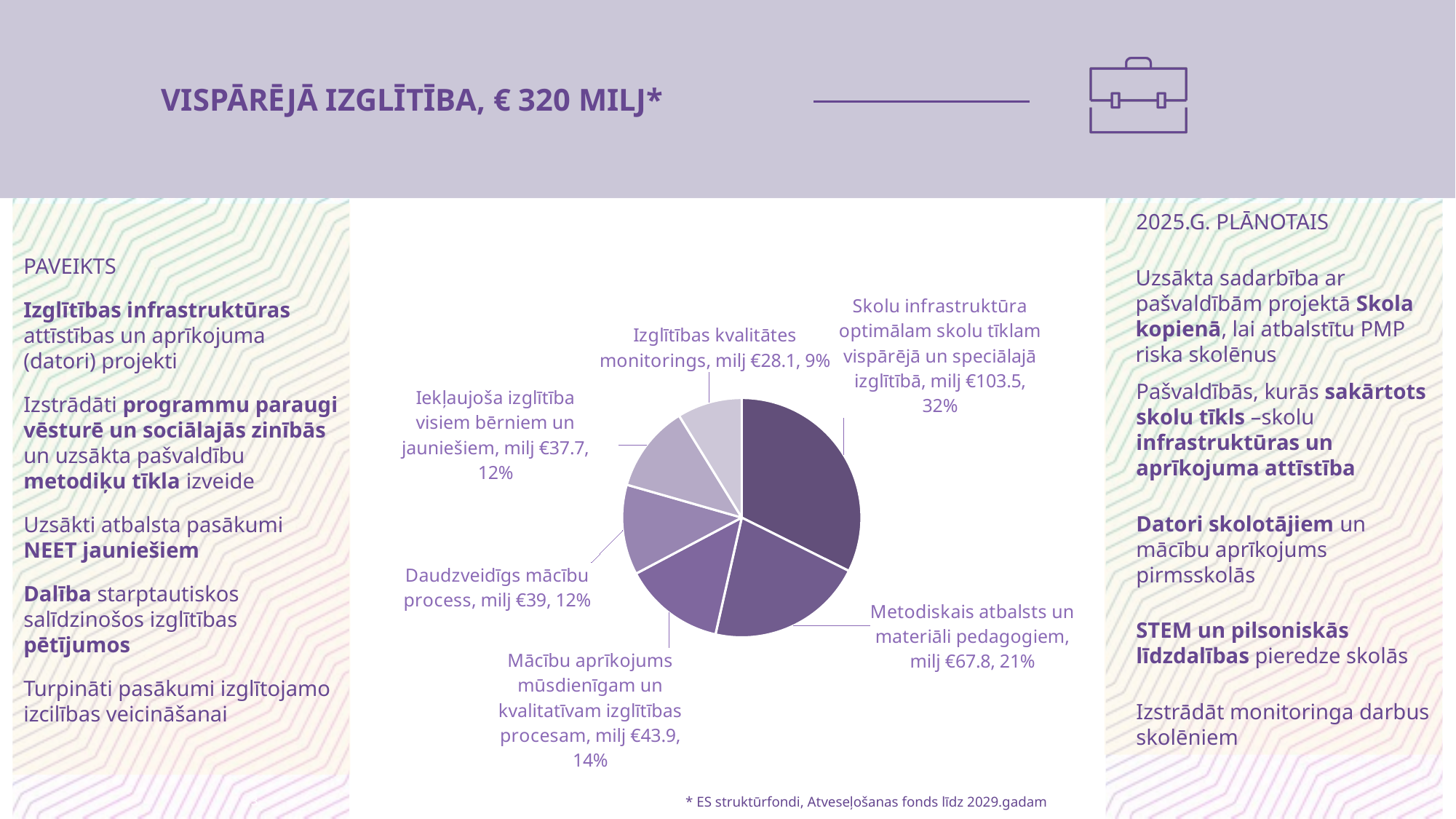
What is the value for Izglītības kvalitātes monitorings? milj €28.1 What is the difference in value between Skolu infrastruktūra and Metodiskais atbalsts un materiāli pedagogiem? milj €35.7 Which category has the largest slice of the pie? Skolu infrastruktūra optimālam skolu tīklam vispārējā un speciālajā izglītībā What is the total amount stated in the slide title for Vispārējā izglītība? € 320 milj Which is larger: Iekļaujoša izglītība visiem bērniem un jauniešiem or Daudzveidīgs mācību process? Daudzveidīgs mācību process What share of the pie does Daudzveidīgs mācību process represent? 12% What share of the pie does Mācību aprīkojums mūsdienīgam un kvalitatīvam izglītības procesam represent? 14% What is the value for Metodiskais atbalsts un materiāli pedagogiem? milj €67.8 What kind of chart is shown on the slide? pie chart What is the value for Skolu infrastruktūra optimālam skolu tīklam vispārējā un speciālajā izglītībā? milj €103.5 How many slices does the pie chart have? 6 Which category has the smallest slice of the pie? Izglītības kvalitātes monitorings